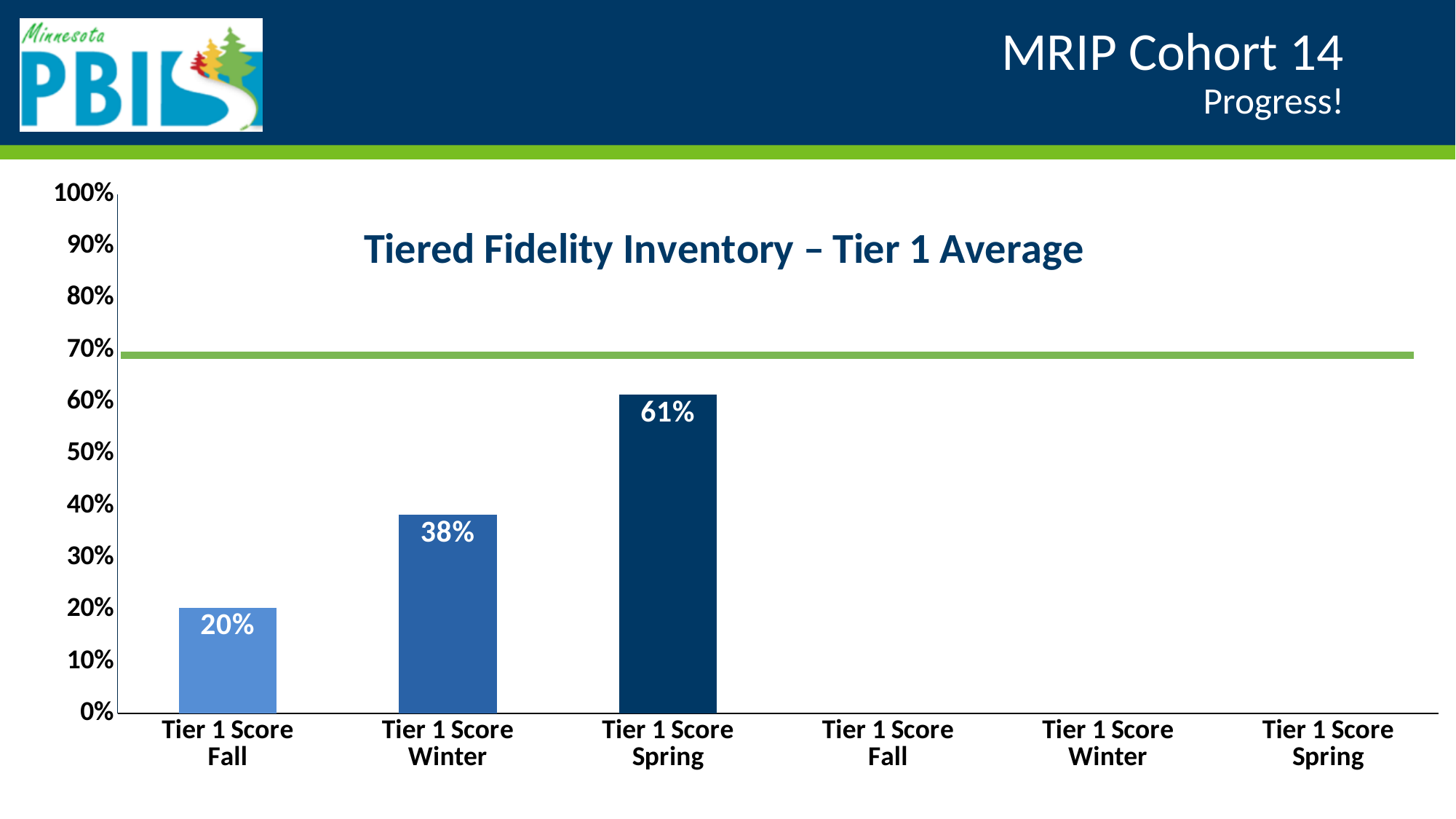
Do the plotted values rise or fall from Fall to Spring? rise Which is larger, the Tier 1 Score Winter value or the Tier 1 Score Spring value? Tier 1 Score Spring What is the difference between the Tier 1 Score Spring value and the Tier 1 Score Fall value? 41% Which plotted bar has the highest value? Tier 1 Score Spring What is the value of the first Tier 1 Score Spring bar? 61% Is the value for Tier 1 Score Spring greater or less than 70%? less How many bars are plotted on the chart? 3 What is the value of the first Tier 1 Score Winter bar? 38% What is the difference between the Tier 1 Score Winter value and the Tier 1 Score Fall value? 18% Which plotted bar has the lowest value? Tier 1 Score Fall What is the value of the first Tier 1 Score Fall bar? 20% What kind of chart is shown on the slide? bar chart